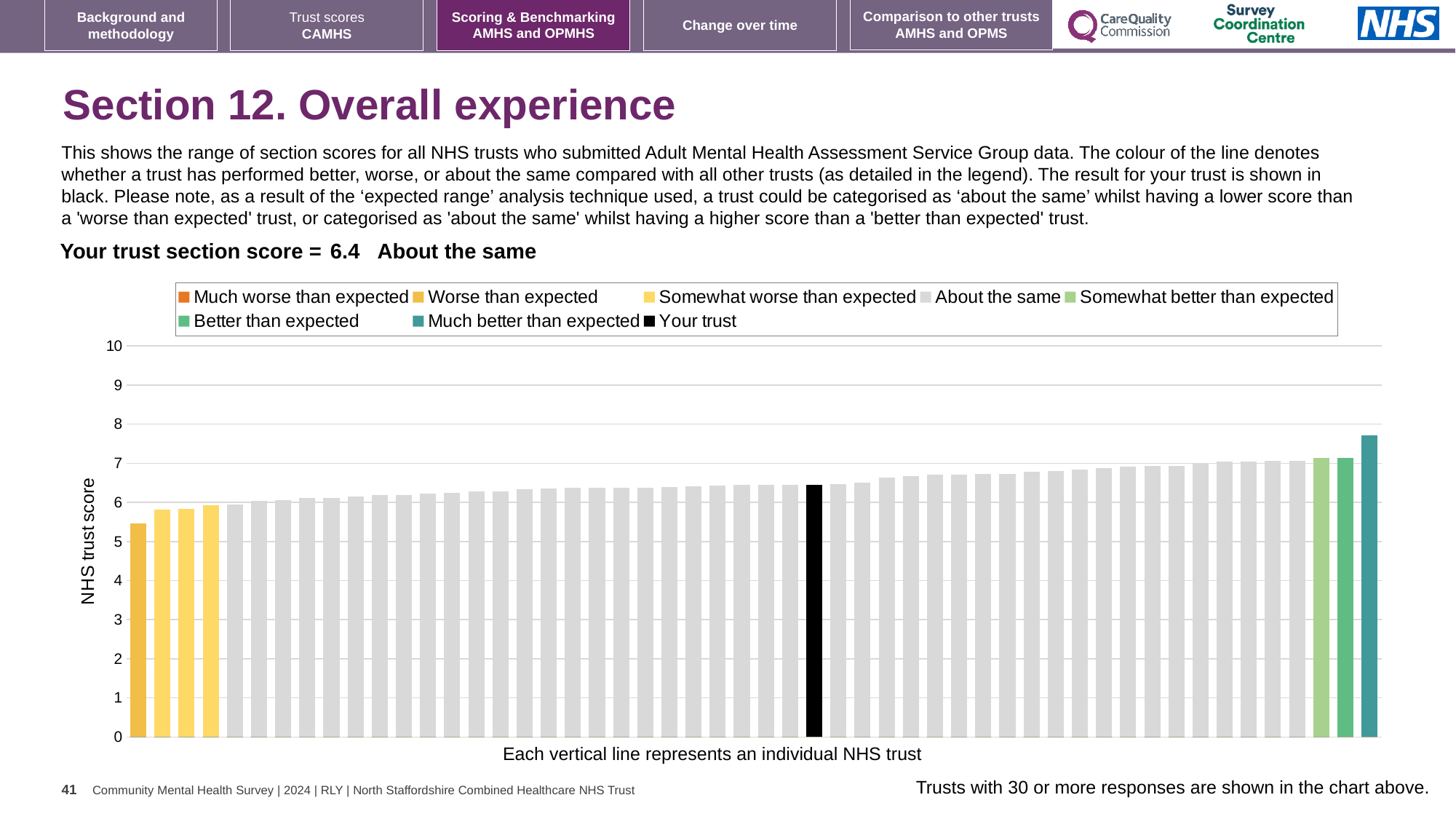
Which category is your trust placed in according to the slide? About the same What is the label on the vertical axis of the chart? NHS trust score Do the bar values rise or fall moving from left to right along the x axis? rise Is the value of the shortest bar in the chart greater or less than 6? less What kind of chart is shown on the slide? bar chart Is the value of the black 'Your trust' bar greater or less than 6? greater What is the section score for your trust shown on the slide? 6.4 How many bars are coloured as 'Worse than expected' (yellow) in the chart? 1 What colour is used for the 'Your trust' bar in the chart? black Which legend category does the tallest bar in the chart belong to? Much better than expected Is the value of the tallest bar in the chart greater or less than 7? greater How many entries does the chart legend list? 8